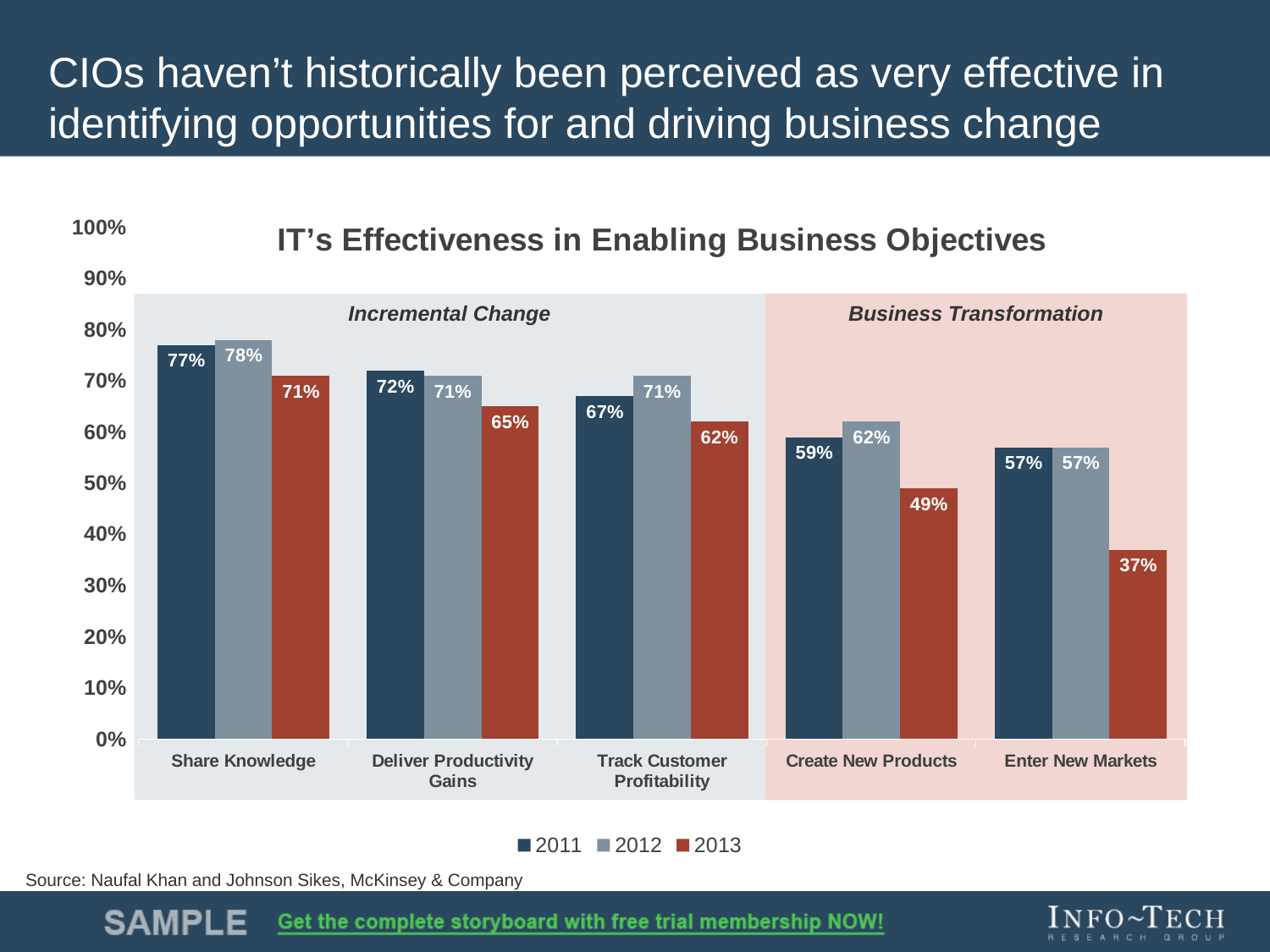
How many series does the legend list? 3 What is the difference between the 2011 and 2013 values for Create New Products? 10% How many categories are shown on the x axis? 5 What kind of chart is shown on the slide? Bar chart What is the 2013 value for Enter New Markets? 37% Which is larger: the 2012 value for Track Customer Profitability or the 2012 value for Enter New Markets? Track Customer Profitability Do the 2013 values rise or fall from Share Knowledge to Enter New Markets? Fall Which category has the highest 2012 value? Share Knowledge Which category has the lowest 2013 value? Enter New Markets What is the title of the chart? IT's Effectiveness in Enabling Business Objectives What is the 2011 value for Deliver Productivity Gains? 72% What is the 2012 value for Create New Products? 62%